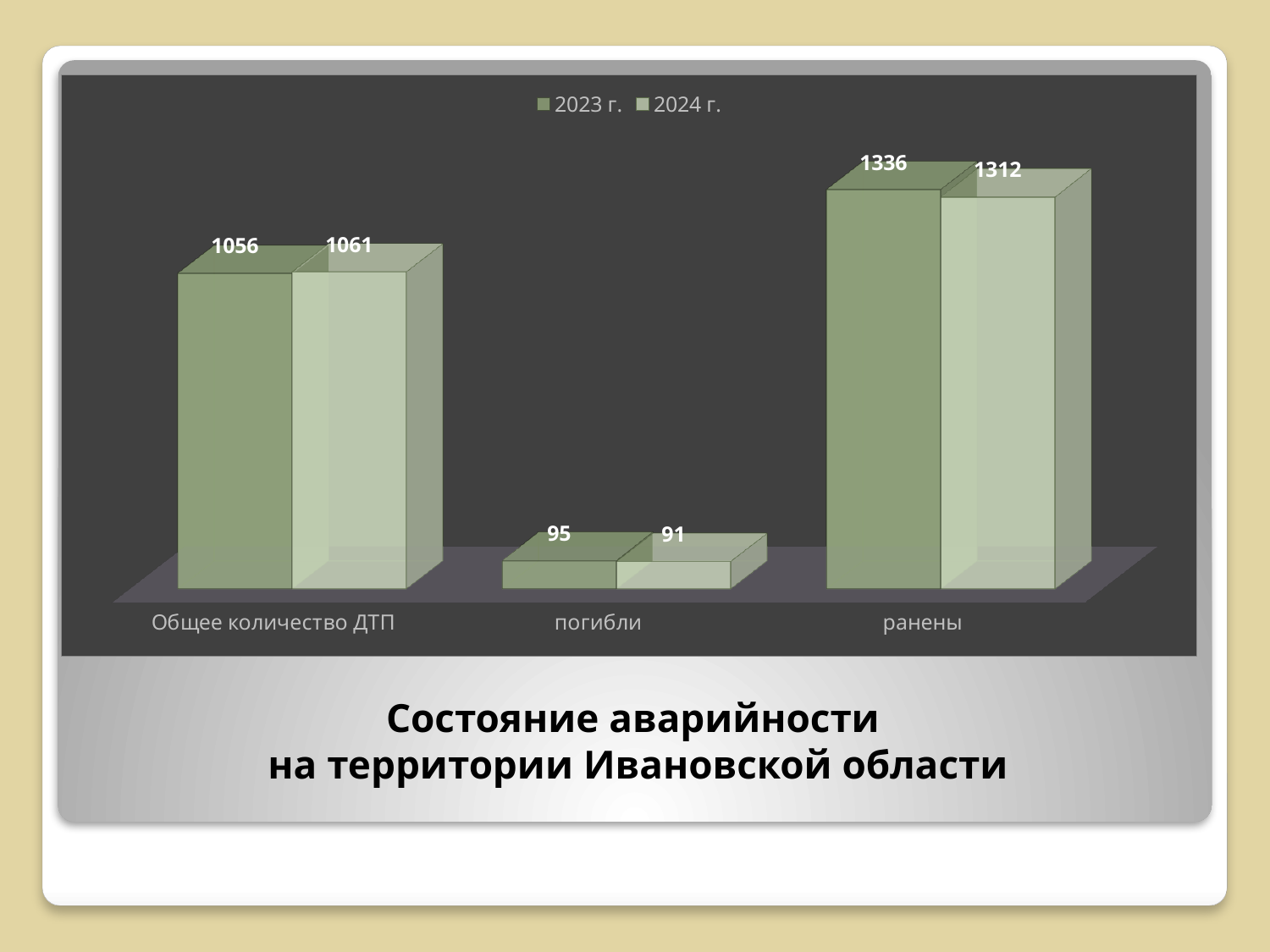
Which category has the highest value for 2023 г.? ранены What is the value for 2023 г. in the category 'ранены'? 1336 Which category has the lowest value for 2024 г.? погибли Which is larger for 'ранены': the 2023 г. value or the 2024 г. value? 2023 г. What is the difference between the 2023 г. and 2024 г. values for 'погибли'? 4 What kind of chart is shown on the slide? bar chart What is the difference between the 2023 г. and 2024 г. values for 'ранены'? 24 What is the value for 2024 г. in the category 'погибли'? 91 How many categories are shown on the x axis? 3 How many series does the legend list? 2 What is the value for 2024 г. in the category 'ранены'? 1312 What is the value for 2023 г. in the category 'Общее количество ДТП'? 1056